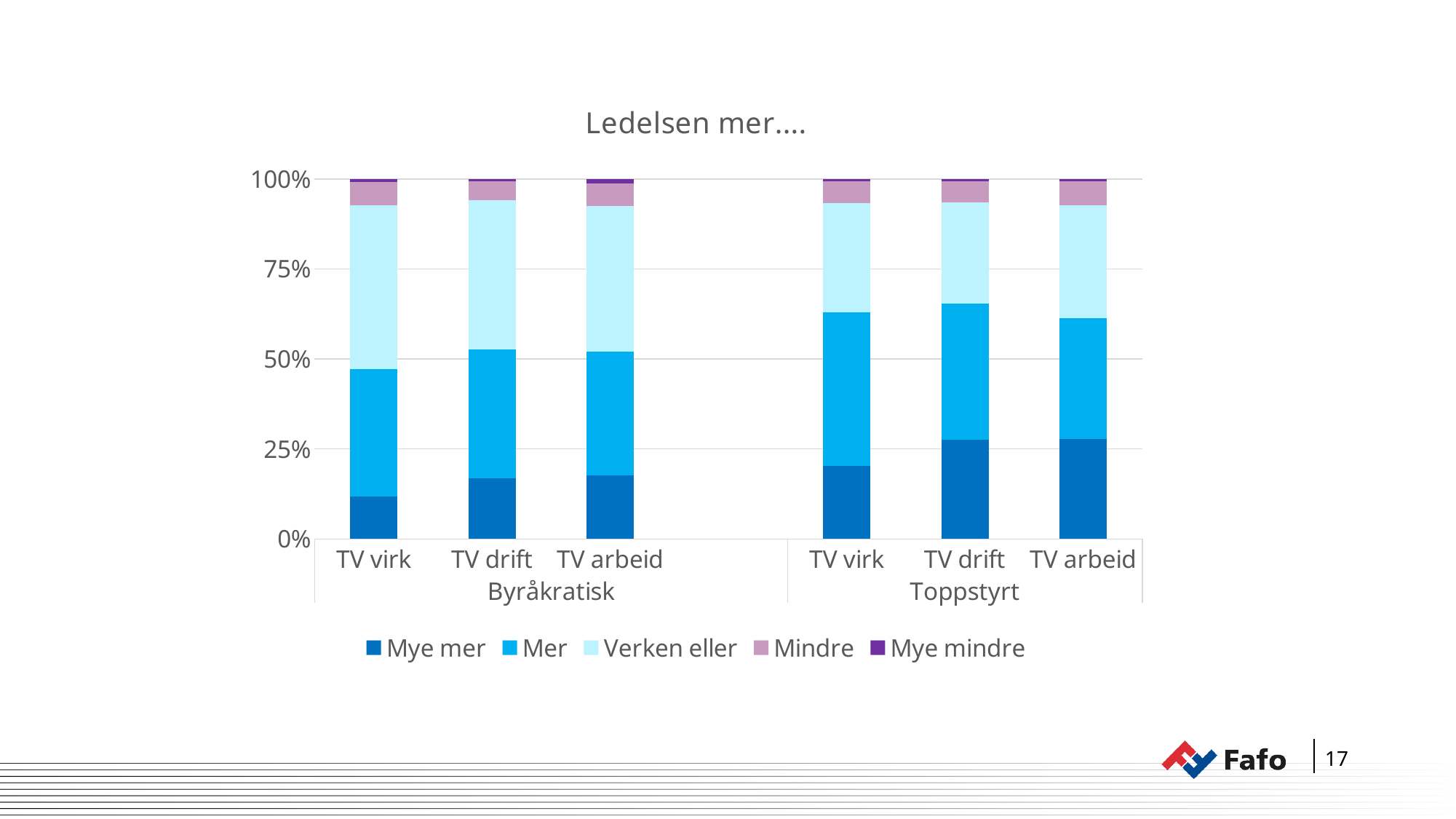
Is the 'Mye mer' share for TV virk in the Byråkratisk group greater or less than 25%? less Which has the larger 'Mye mer' share: TV virk in the Byråkratisk group or TV virk in the Toppstyrt group? TV virk in the Toppstyrt group What kind of chart is shown on the slide? stacked bar chart What is the title of the chart? Ledelsen mer.... Is the combined 'Mye mer' and 'Mer' share for TV drift in the Toppstyrt group greater or less than 50%? greater How many bars are plotted in the chart? 6 Which bar has the smallest 'Mye mer' share? TV virk (Byråkratisk) Is the 'Mye mer' share for TV arbeid in the Toppstyrt group greater or less than 25%? greater Which two groups are the bars divided into along the x axis? Byråkratisk and Toppstyrt What does each stacked bar total? 100% How many series does the legend list? 5